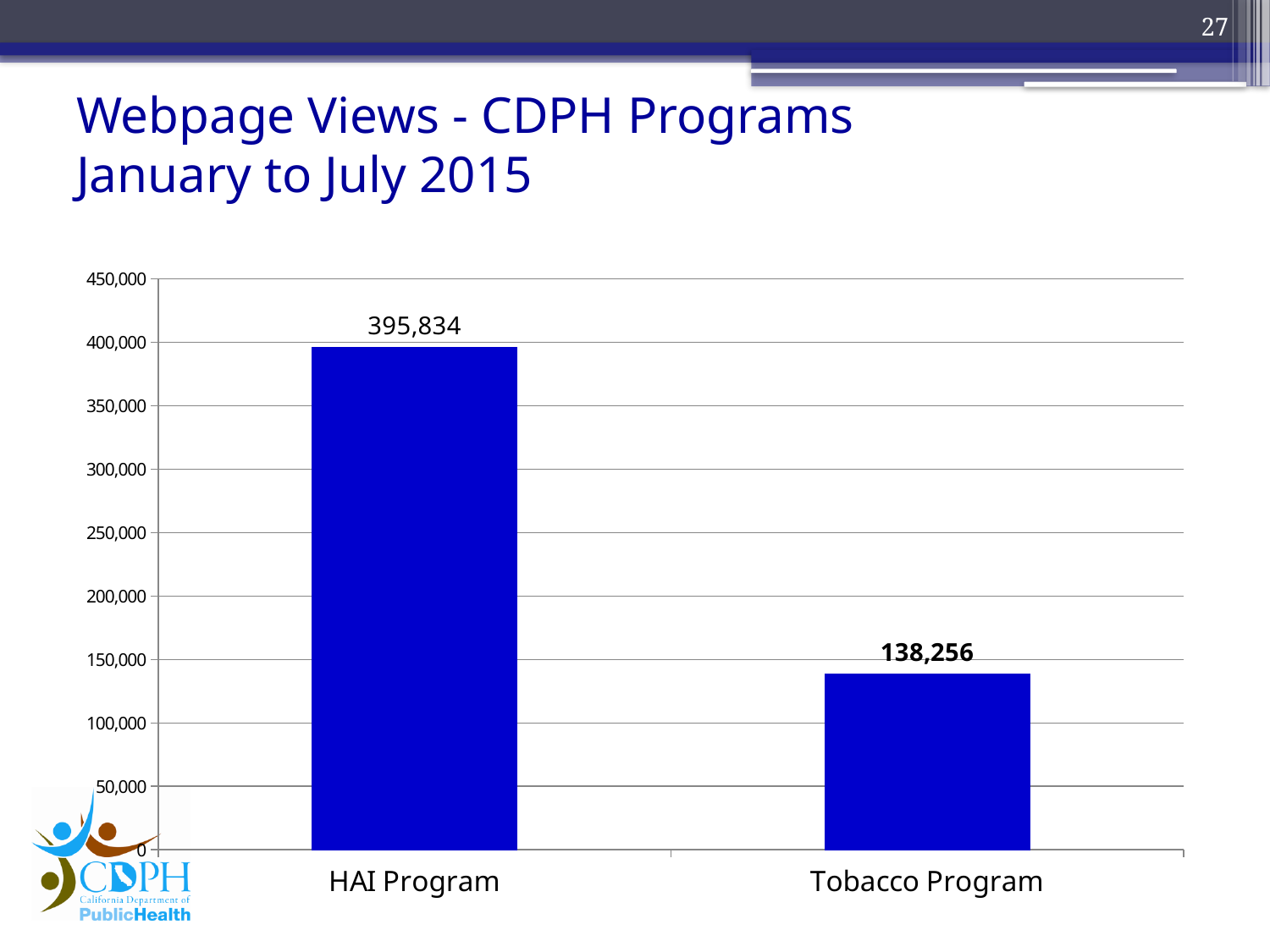
What is the maximum value shown on the vertical axis? 450,000 What is the number of webpage views for the Tobacco Program? 138,256 What is the title of the slide? Webpage Views - CDPH Programs January to July 2015 How many programs are shown in the chart? 2 Which has more webpage views, the HAI Program or the Tobacco Program? HAI Program What kind of chart is shown on the slide? Bar chart What is the difference in webpage views between the HAI Program and the Tobacco Program? 257,578 Which program has the highest number of webpage views? HAI Program What is the number of webpage views for the HAI Program? 395,834 Which program has the lowest number of webpage views? Tobacco Program Is the value for the HAI Program greater or less than 350,000? greater Is the value for the Tobacco Program greater or less than 150,000? less